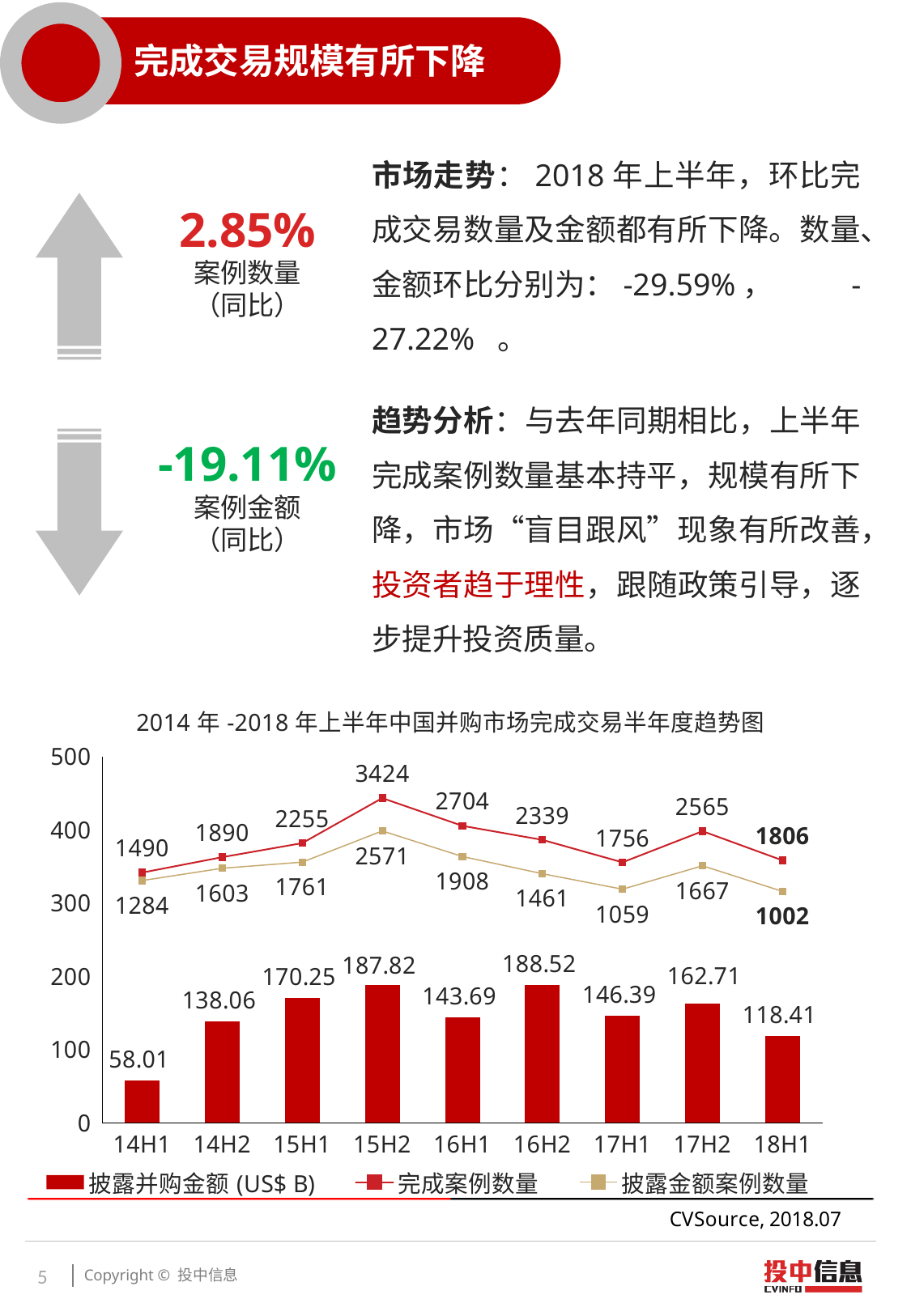
How many series does the legend list? 3 How many periods are shown on the x axis? 9 What is the difference between the 完成案例数量 and 披露金额案例数量 values in 18H1? 804 Which is larger, the 披露并购金额 (US$ B) for 15H1 or for 17H2? 15H1 What is the 披露金额案例数量 value for 17H1? 1059 What is the 完成案例数量 value for 15H2? 3424 Which period has the lowest 披露并购金额 (US$ B)? 14H1 What is the 披露并购金额 (US$ B) value for 18H1? 118.41 What kind of chart is this? Combined bar and line chart Which period has the highest 披露并购金额 (US$ B)? 16H2 Which period has the lowest 披露金额案例数量? 18H1 What is the title of the chart? 2014年-2018年上半年中国并购市场完成交易半年度趋势图